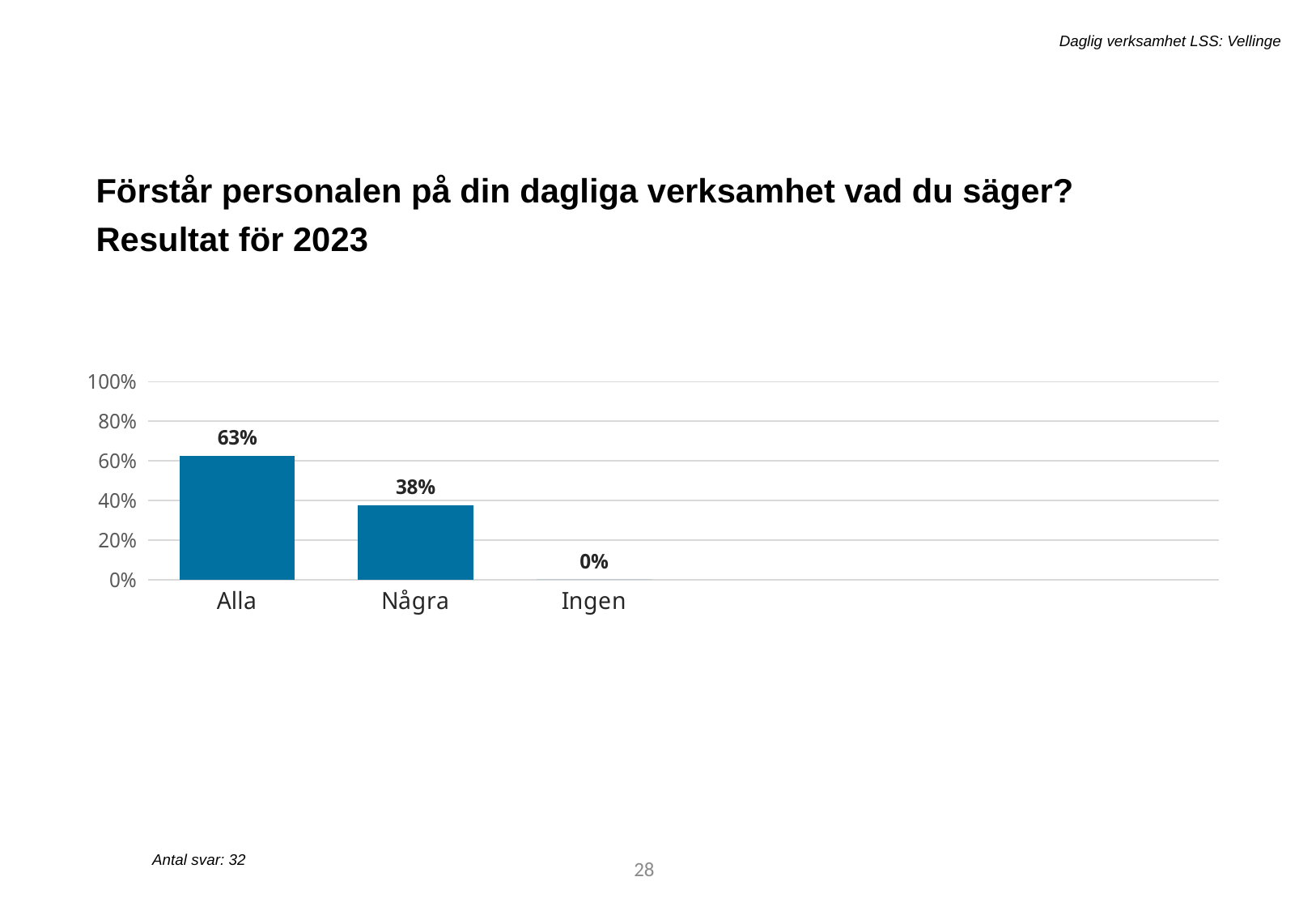
What is the value for Några? 38% Is the value for Alla greater or less than 60%? greater How many categories are shown on the x axis? 3 Which category has the highest value? Alla What kind of chart is shown on the slide? bar chart Which category has the lowest value? Ingen Do the values rise or fall from left to right along the x axis? fall Is the value for Några greater or less than 40%? less Which is larger, the value for Alla or the value for Några? Alla What is the value for Ingen? 0% What is the value for Alla? 63% What is the difference between the values for Alla and Några? 25%